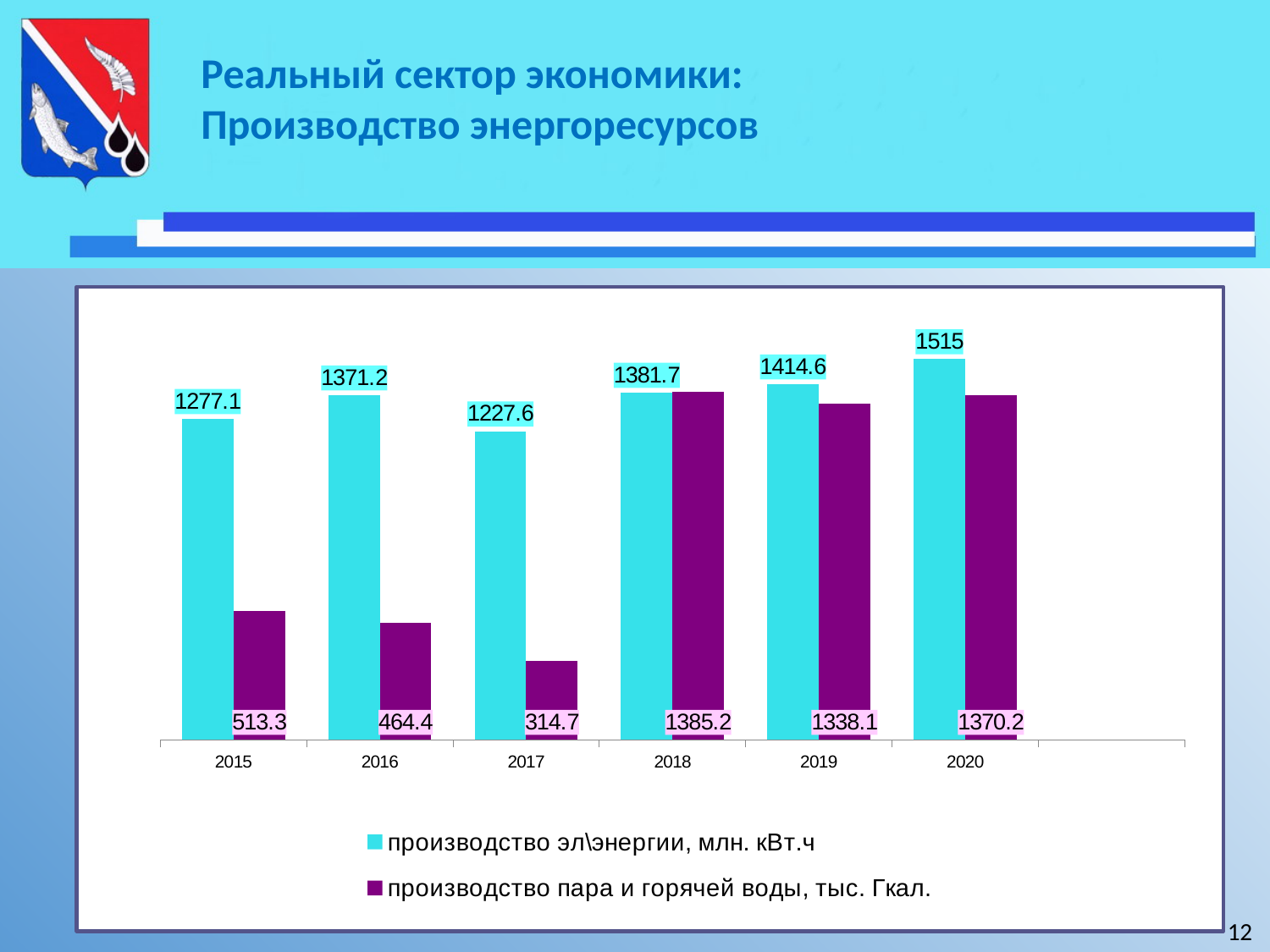
What type of chart is shown on the slide? bar chart In which year was steam and hot water production the lowest? 2017 What was the electricity production (производство эл\энергии, млн. кВт.ч) in 2020? 1515 What was the steam and hot water production in 2018? 1385.2 How many years are shown on the x axis of the chart? 6 Which was larger in 2016: electricity production or steam and hot water production? electricity production How many series does the chart legend list? 2 What was the electricity production in 2015? 1277.1 What was the steam and hot water production (производство пара и горячей воды, тыс. Гкал.) in 2017? 314.7 Which colour represents steam and hot water production in the chart? purple What is the difference between electricity production in 2020 and in 2019? 100.4 In which year was electricity production the highest? 2020